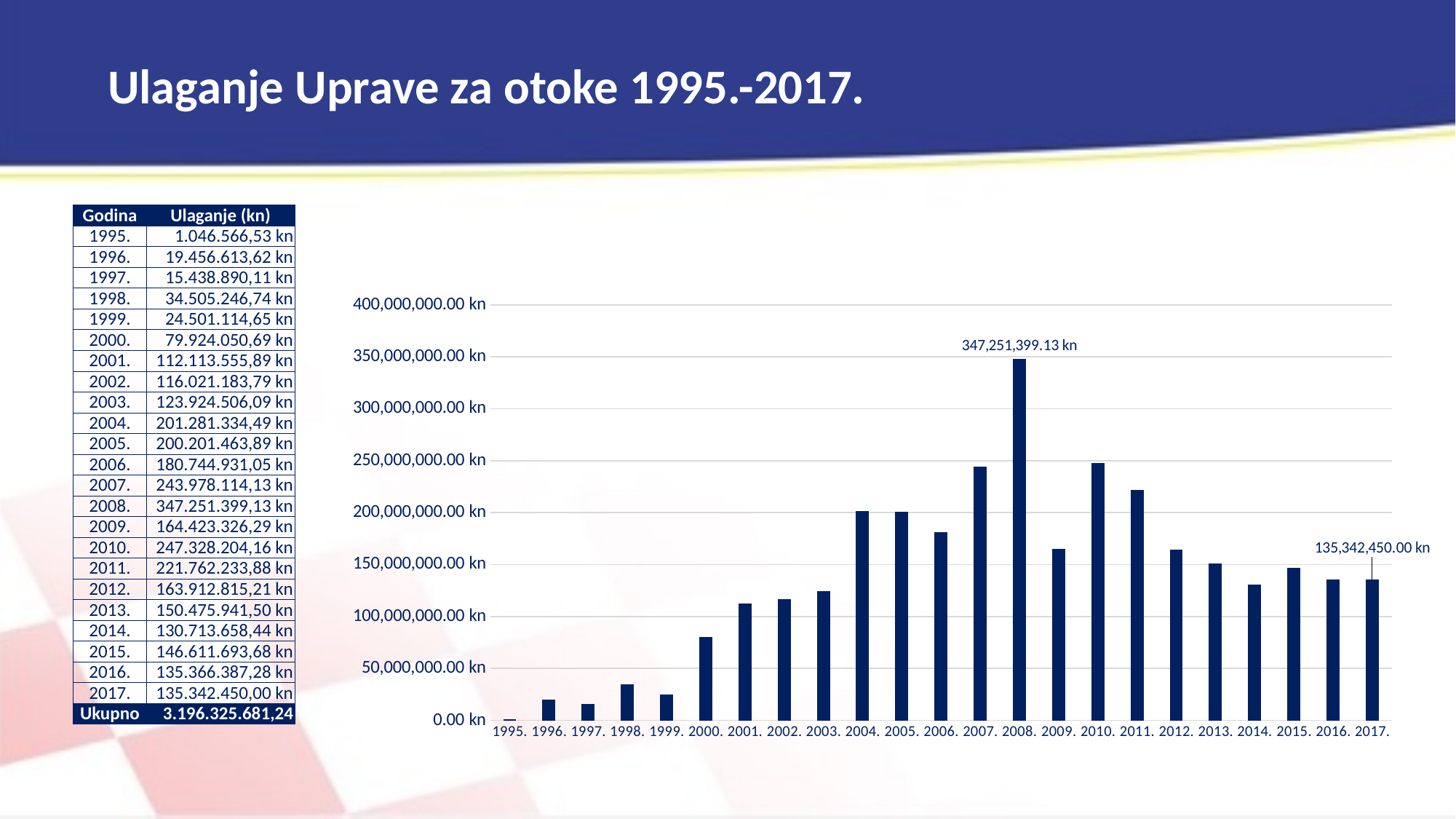
Is the value for 2010 greater or less than 200,000,000.00 kn? greater Is the value for 2014 greater or less than 150,000,000.00 kn? less Is the value for 2000 greater or less than 100,000,000.00 kn? less Which year has the highest bar in the chart? 2008. Do the values rise or fall from 1999 to 2004 in the chart? rise Which year has the larger value, 2010 or 2011? 2010. What is the difference between the labelled values for 2008 and 2017 in the chart? 211,908,949.13 kn What value is labelled on the bar for 2017 in the chart? 135,342,450.00 kn Which year has the lowest bar in the chart? 1995. What kind of chart is shown on the slide? bar chart What value is labelled on the bar for 2008 in the chart? 347,251,399.13 kn How many years (bars) are plotted in the chart? 23